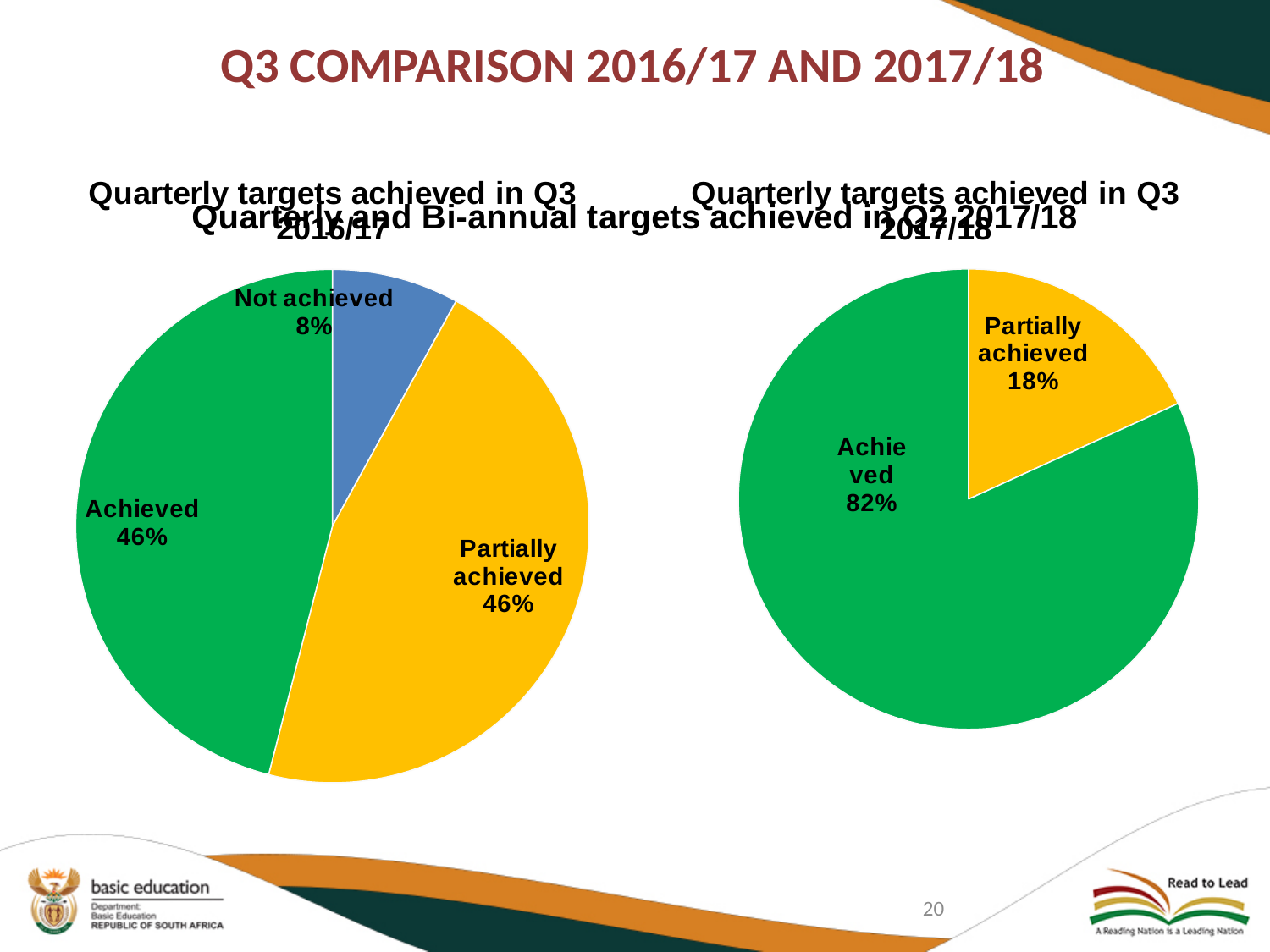
In the left pie chart (Q3 2016/17), which category has the smallest share? Not achieved How many slices does the left pie chart (Q3 2016/17) have? 3 In the right pie chart (Q3 2017/18), what is the difference between the Achieved and Partially achieved shares? 64 percentage points What is the difference between the Achieved share in the right chart (2017/18) and the Achieved share in the left chart (2016/17)? 36 percentage points In the left pie chart (Q3 2016/17), what percentage of targets were achieved? 46% In the right pie chart (Q3 2017/18), what percentage of targets were achieved? 82% In the right pie chart (Q3 2017/18), what percentage of targets were partially achieved? 18% How many slices does the right pie chart (Q3 2017/18) have? 2 Which chart shows a larger Partially achieved share, the left (2016/17) or the right (2017/18)? Left (2016/17) In the left pie chart (Q3 2016/17), what percentage of targets were not achieved? 8% In the right pie chart (Q3 2017/18), which category has the largest share? Achieved What type of chart is used on this slide? Pie chart